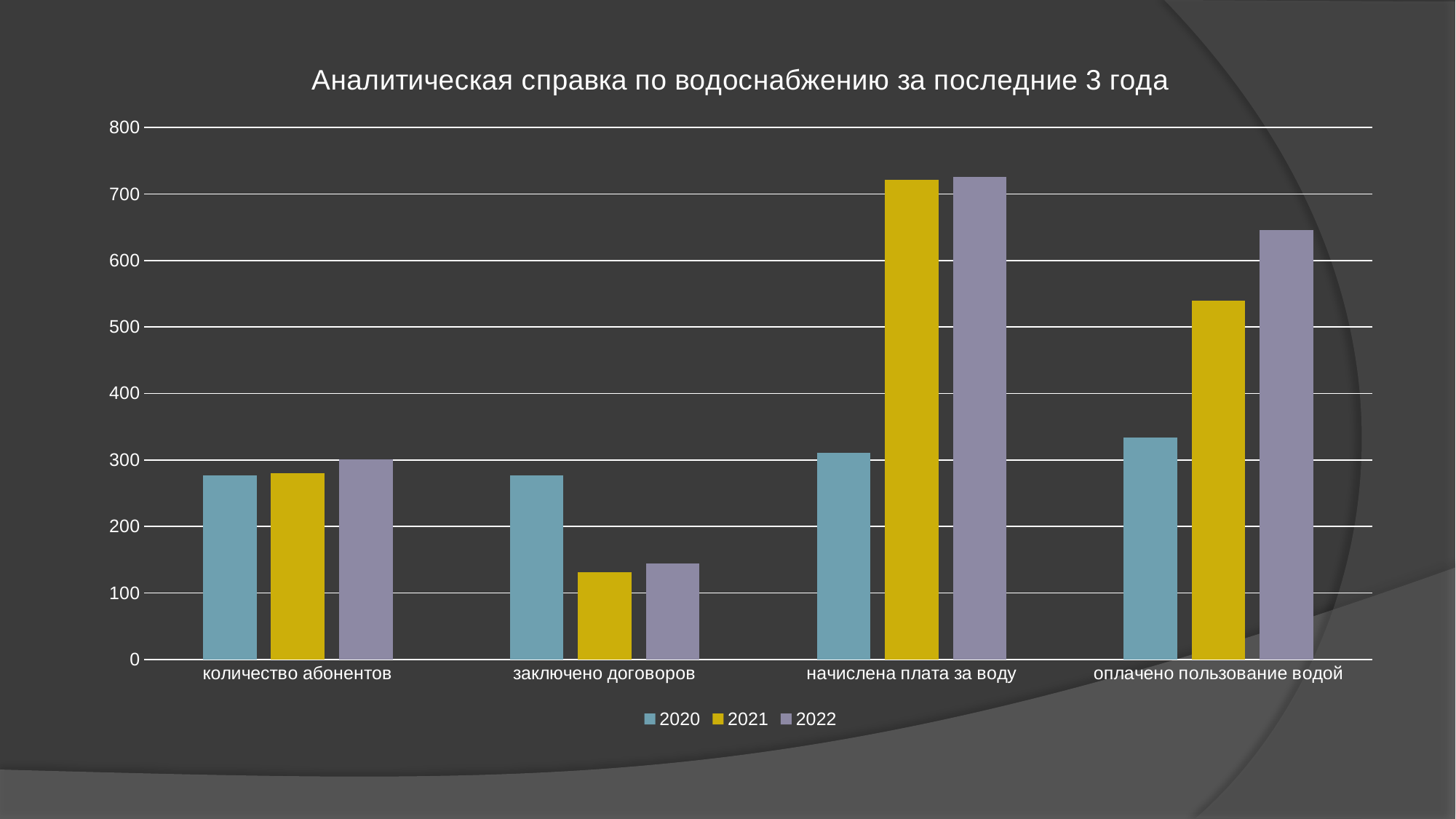
For 'оплачено пользование водой', which year has the highest value? 2022 For 'начислена плата за воду', which is larger: the 2020 value or the 2021 value? 2021 What kind of chart is shown on the slide? bar chart Is the 2021 value for 'начислена плата за воду' greater or less than 700? greater Is the 2022 value for 'оплачено пользование водой' greater or less than 600? greater Is the 2020 value for 'количество абонентов' greater or less than 300? less What is the title of the chart? Аналитическая справка по водоснабжению за последние 3 года How many series does the legend list? 3 Which years are listed in the legend? 2020, 2021, 2022 How many categories are shown on the x axis? 4 For 'заключено договоров', which year has the lowest value? 2021